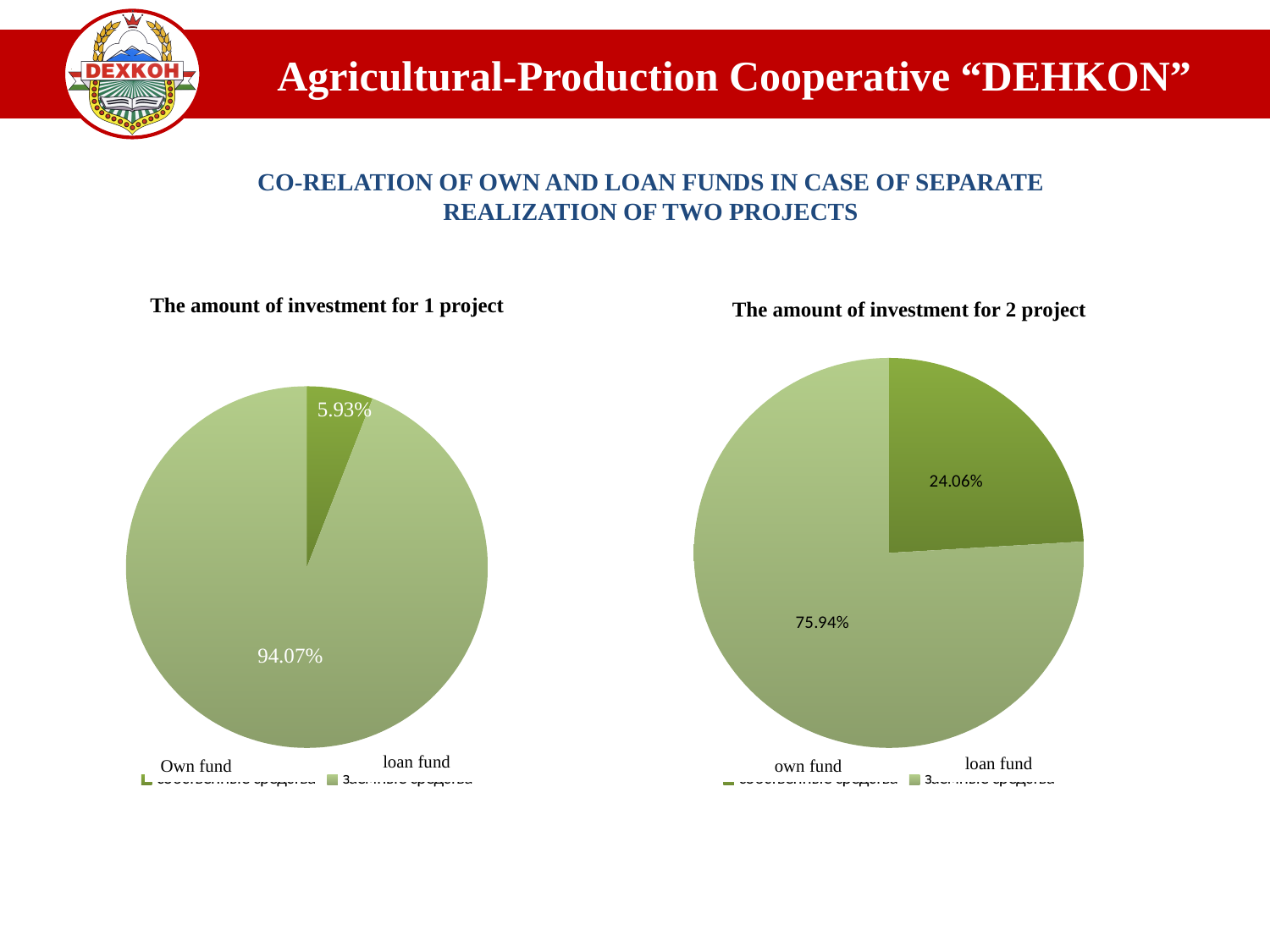
In "The amount of investment for 2 project", which slice is the smallest? own fund In "The amount of investment for 2 project", what share does the own fund slice have? 24.06% In "The amount of investment for 2 project", what is the difference between the loan fund share and the own fund share? 51.88% In "The amount of investment for 1 project", which slice is the largest? loan fund In "The amount of investment for 1 project", what share does the loan fund slice have? 94.07% What kind of chart is "The amount of investment for 1 project"? pie chart How many pie charts are shown on the slide? 2 In "The amount of investment for 1 project", what is the difference between the loan fund share and the own fund share? 88.14% In "The amount of investment for 1 project", what share does the own fund slice have? 5.93% How many slices does the pie chart "The amount of investment for 2 project" have? 2 Which chart has the larger own fund share, "The amount of investment for 1 project" or "The amount of investment for 2 project"? The amount of investment for 2 project